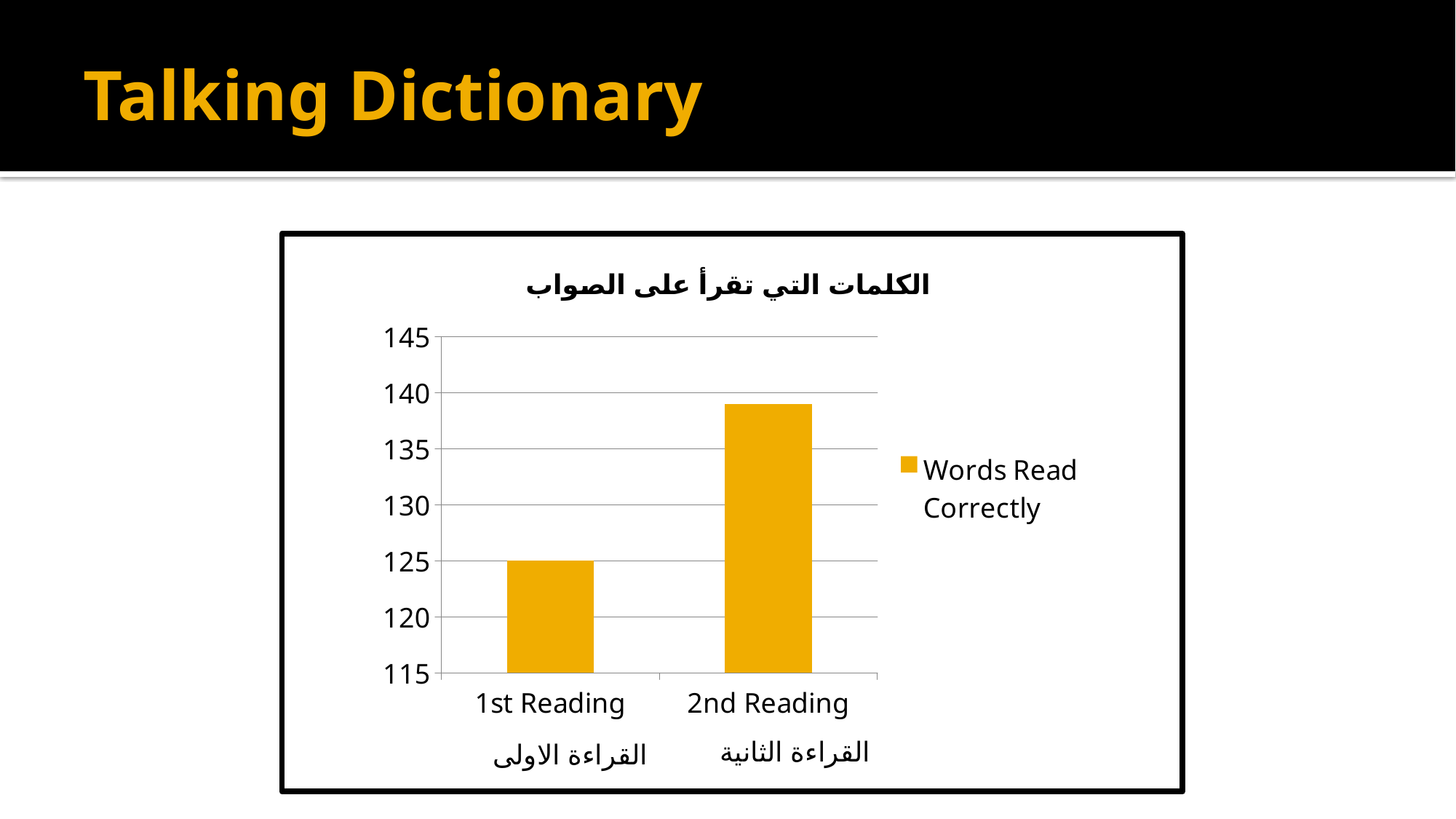
Which category has the lowest value? 1st Reading Is the value for 1st Reading greater or less than 130? less What is the name of the series in the legend? Words Read Correctly Which is larger, the value for 1st Reading or 2nd Reading? 2nd Reading How many series does the legend list? 1 Is the value for 2nd Reading greater or less than 135? greater Do the values rise or fall from 1st Reading to 2nd Reading? rise Which category has the highest value? 2nd Reading How many categories are shown on the x axis? 2 What is the value for 1st Reading? 125 What kind of chart is shown? bar chart What colour are the bars? orange